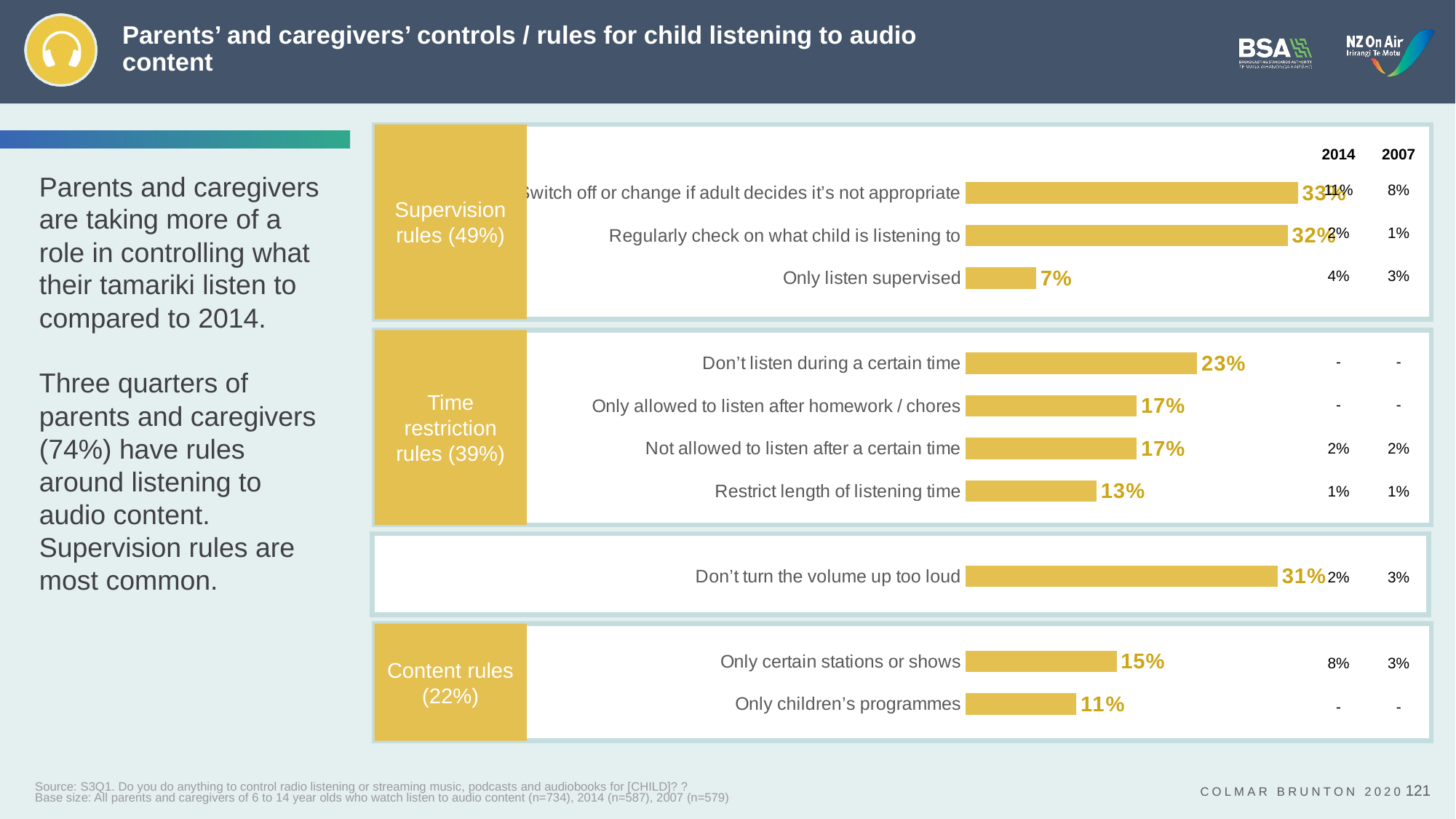
What percentage is shown for 'Don't listen during a certain time'? 23% What percentage is shown for 'Don't turn the volume up too loud'? 31% Which rule has the lowest percentage in the chart? Only listen supervised What is the 2014 value shown for 'Only certain stations or shows'? 8% What type of chart is used on this slide? Bar chart Which rule has the highest percentage in the chart? Switch off or change if adult decides it's not appropriate What is the difference between 'Don't listen during a certain time' and 'Restrict length of listening time'? 10 percentage points What percentage is shown for 'Only children's programmes'? 11% What percentage is shown in the 'Content rules' group label? 22% Which is larger: 'Only certain stations or shows' or 'Only children's programmes'? Only certain stations or shows What percentage is shown for 'Only listen supervised'? 7% How many rules (bars) are plotted in the chart? 10